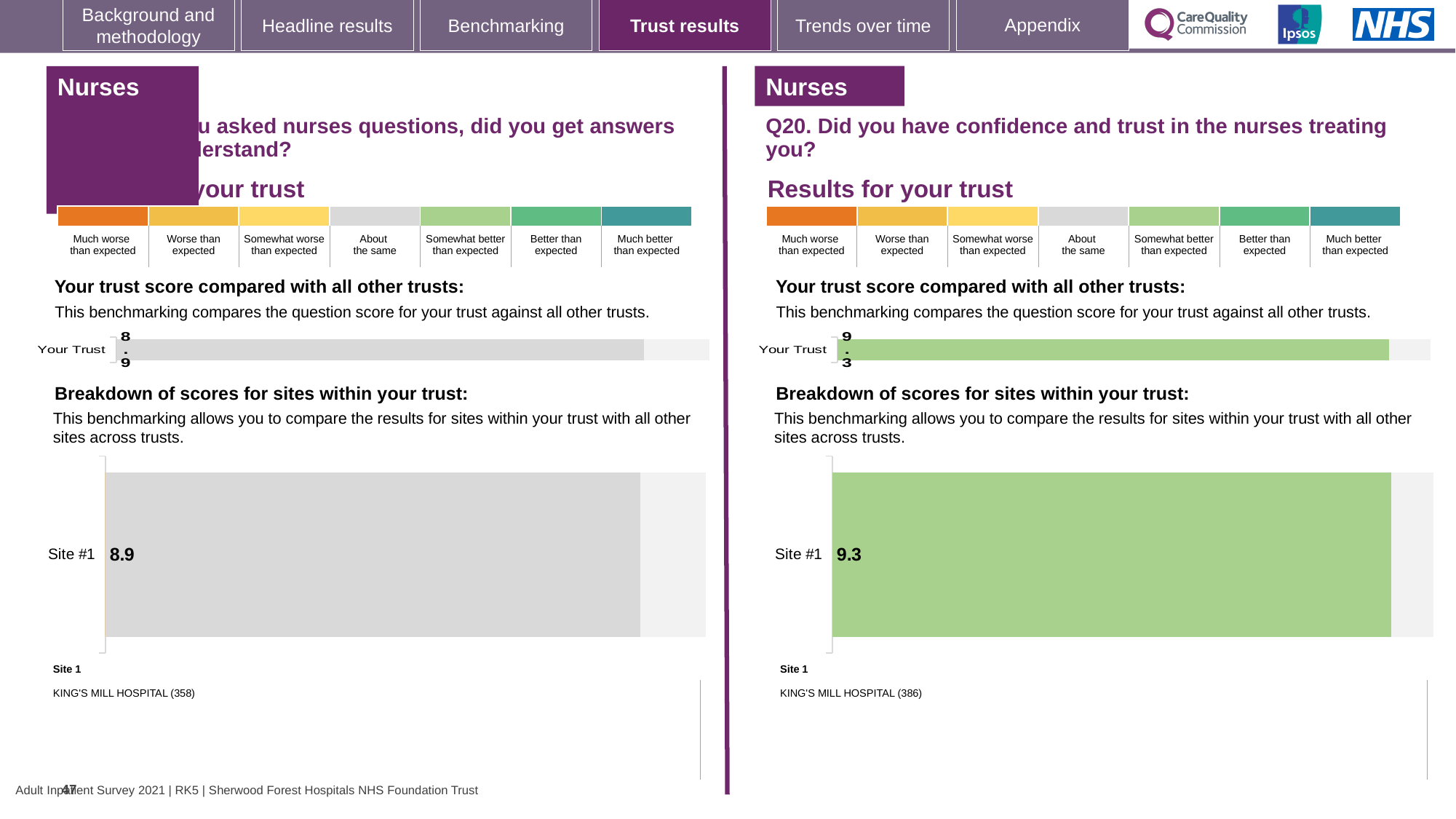
Which site name is listed under Site 1 in the right-hand (Q20) site breakdown? KING'S MILL HOSPITAL (386) What type of chart is used to show the Site #1 score in the left-hand site breakdown? Bar chart Is the 'Your Trust' score in the left-hand trust score chart greater or less than 9? less Is the 'Your Trust' score in the right-hand (Q20) trust score chart greater or less than 9? greater What is the difference between the Site #1 score in the right-hand (Q20) site breakdown chart and the Site #1 score in the left-hand site breakdown chart? 0.4 In the left-hand 'Breakdown of scores for sites within your trust' chart, what is the score for Site #1? 8.9 Which is larger: the Site #1 score in the left-hand site breakdown chart or the Site #1 score in the right-hand (Q20) site breakdown chart? The right-hand (Q20) chart, 9.3 What colour is the Site #1 bar in the right-hand (Q20) site breakdown chart? Light green On the left half of the slide, what is the 'Your Trust' score shown in the trust score bar chart? 8.9 How many sites are plotted in the right-hand (Q20) 'Breakdown of scores for sites within your trust' chart? 1 On the right half of the slide (Q20), what is the 'Your Trust' score shown in the trust score bar chart? 9.3 In the right-hand 'Breakdown of scores for sites within your trust' chart (Q20), what is the score for Site #1? 9.3